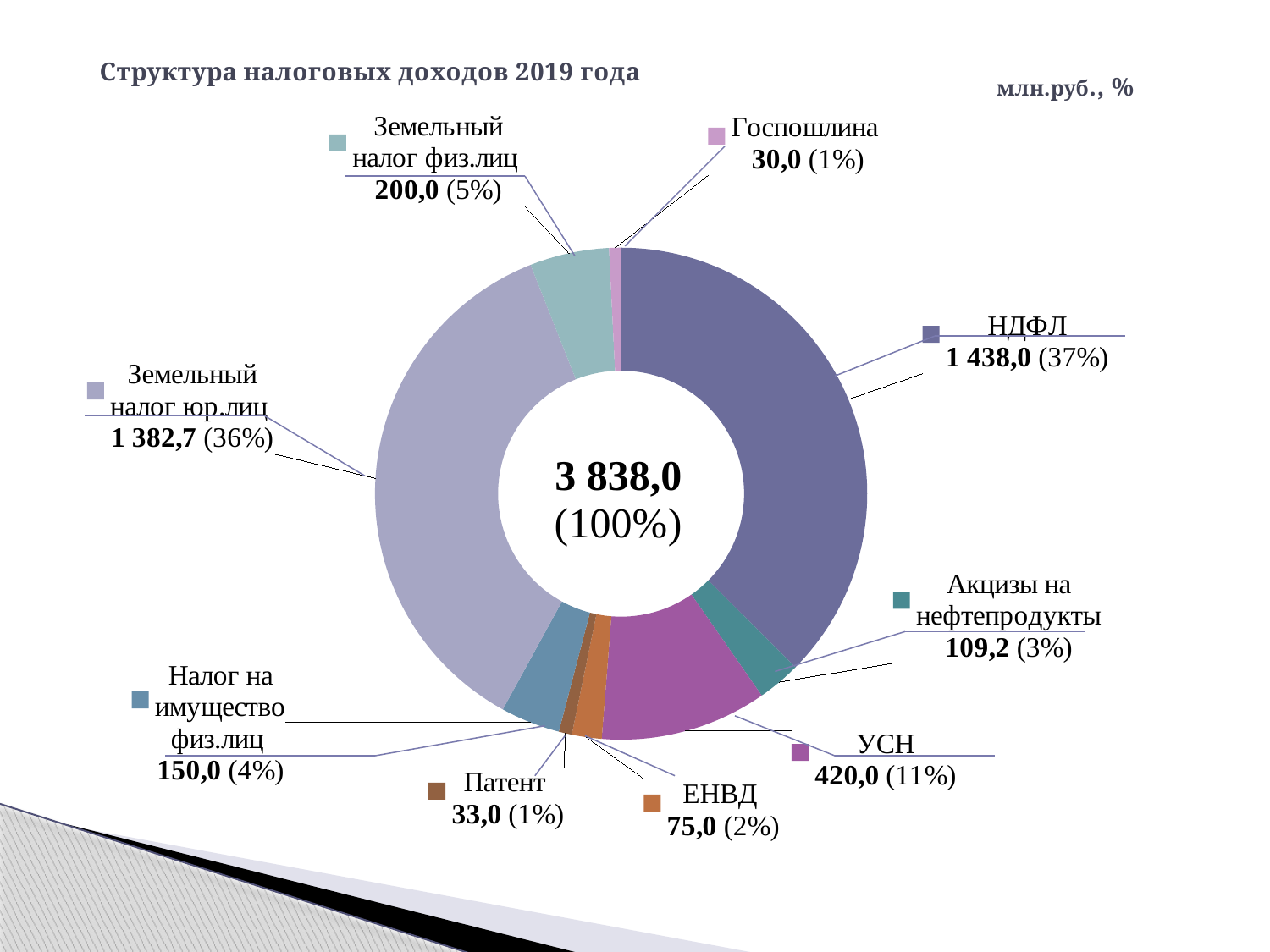
How many categories are shown in the chart? 9 What is the difference between the values for НДФЛ and Земельный налог юр.лиц? 55,3 What is the value for Акцизы на нефтепродукты? 109,2 What total value is shown in the centre of the chart? 3 838,0 What share of the total does Земельный налог физ.лиц account for? 5% What share of the total does УСН account for? 11% Which category has the largest value? НДФЛ Which category has the smallest value? Госпошлина What is the title of the chart? Структура налоговых доходов 2019 года Which is larger, the value for ЕНВД or the value for Патент? ЕНВД What is the value for НДФЛ? 1 438,0 What kind of chart is shown on the slide? Doughnut chart